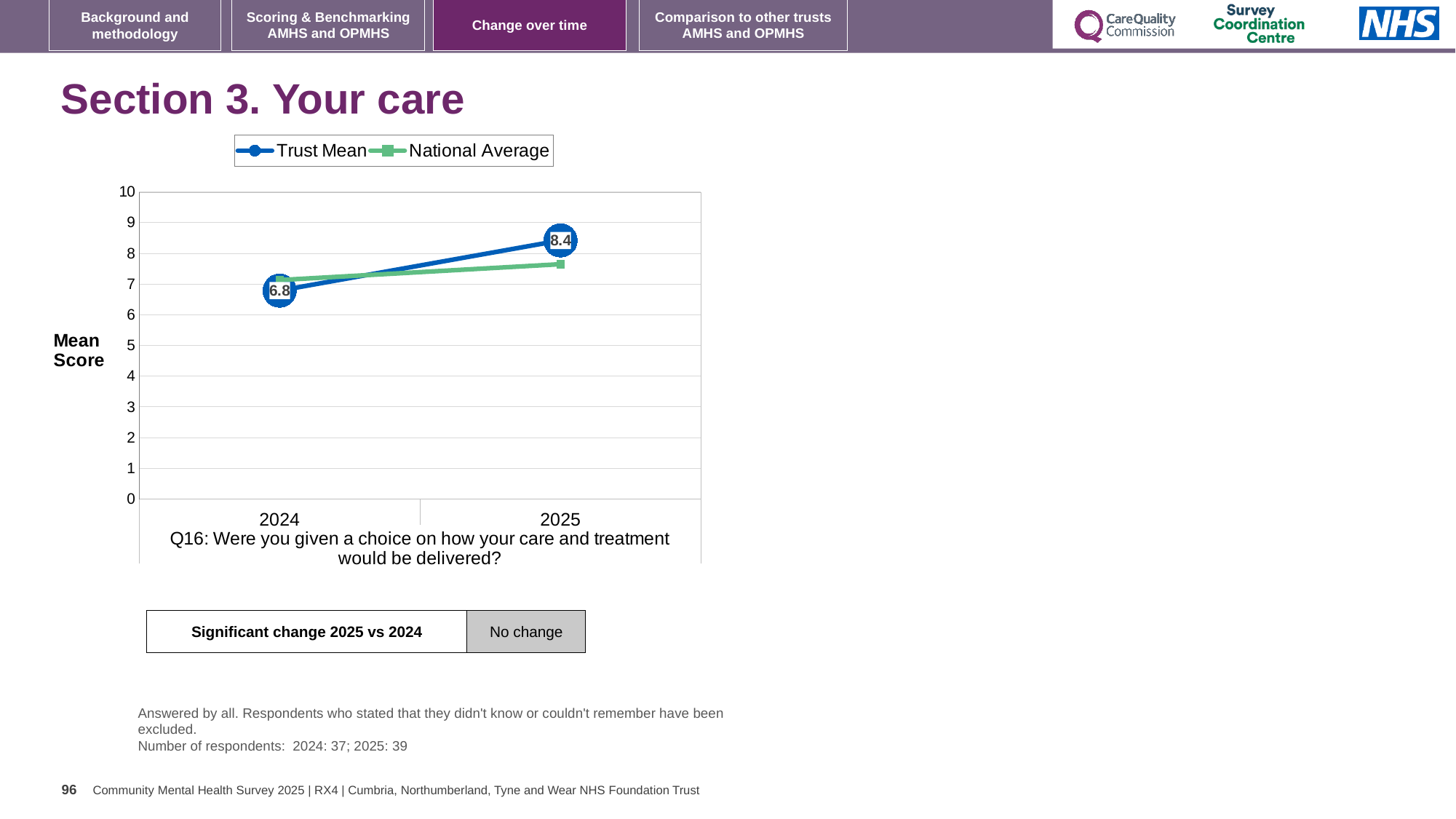
Does the Trust Mean rise or fall from 2024 to 2025? rise How many series does the legend list? 2 Which year has the higher Trust Mean score? 2025 What is the Trust Mean score for 2024? 6.8 By how much did the Trust Mean change from 2024 to 2025? 1.6 What is the Trust Mean score for 2025? 8.4 Is the National Average for 2025 greater or less than 8? less What kind of chart is shown? line chart How many years are plotted on the x axis? 2 In 2025, which is larger: the Trust Mean or the National Average? Trust Mean What is the label on the y axis of the chart? Mean Score